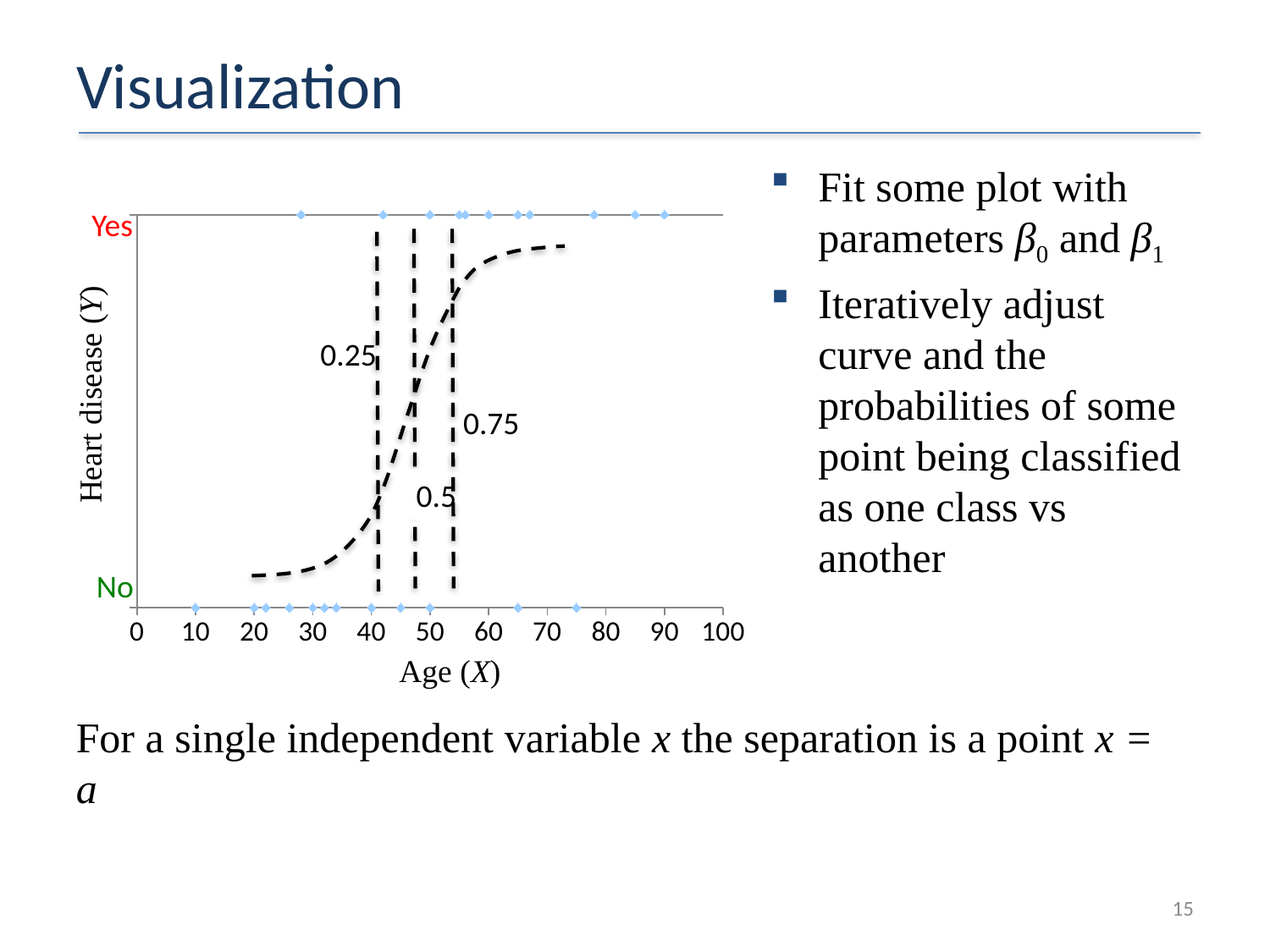
How many dashed vertical lines are drawn on the chart? 3 What is the highest value shown on the x axis of the chart? 100 Is the age of the rightmost 'No' point greater or less than 70? greater Is the age of the leftmost 'Yes' point greater or less than 20? greater What is the lowest value shown on the x axis of the chart? 0 Does the fitted dashed curve rise or fall as Age increases? rises What are the two category labels shown on the y axis of the chart? Yes and No What kind of chart is shown on the slide? scatter plot What probability labels are attached to the dashed vertical lines on the chart? 0.25, 0.5, 0.75 What is the title of the x axis of the chart? Age (X) What is the spacing between consecutive tick labels on the x axis of the chart? 10 What is the title of the y axis of the chart? Heart disease (Y)